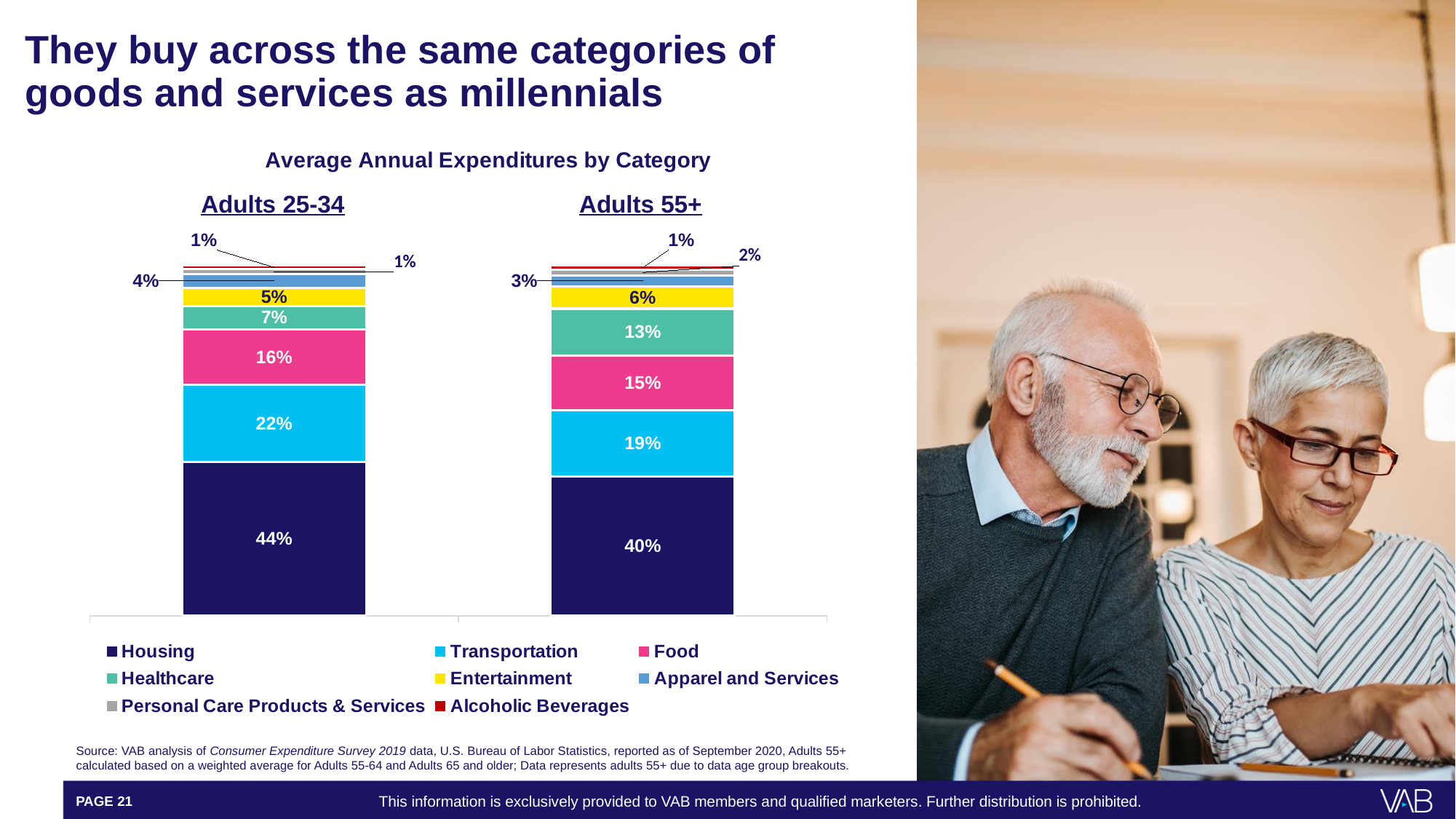
What is the Healthcare share for Adults 55+? 13% Which category has the largest share of expenditures for Adults 55+? Housing Which age group has the larger Healthcare share, Adults 25-34 or Adults 55+? Adults 55+ How many age groups (bars) are shown in the chart? 2 What is the Entertainment share for Adults 25-34? 5% How many categories does the legend list? 8 What share of average annual expenditures goes to Housing for Adults 25-34? 44% How many percentage points higher is the Housing share for Adults 25-34 than for Adults 55+? 4 percentage points What type of chart is used to show Average Annual Expenditures by Category? Stacked bar chart What share of average annual expenditures goes to Transportation for Adults 55+? 19% Which age group has the larger Food share, Adults 25-34 or Adults 55+? Adults 25-34 What is the Apparel and Services share for Adults 55+? 3%